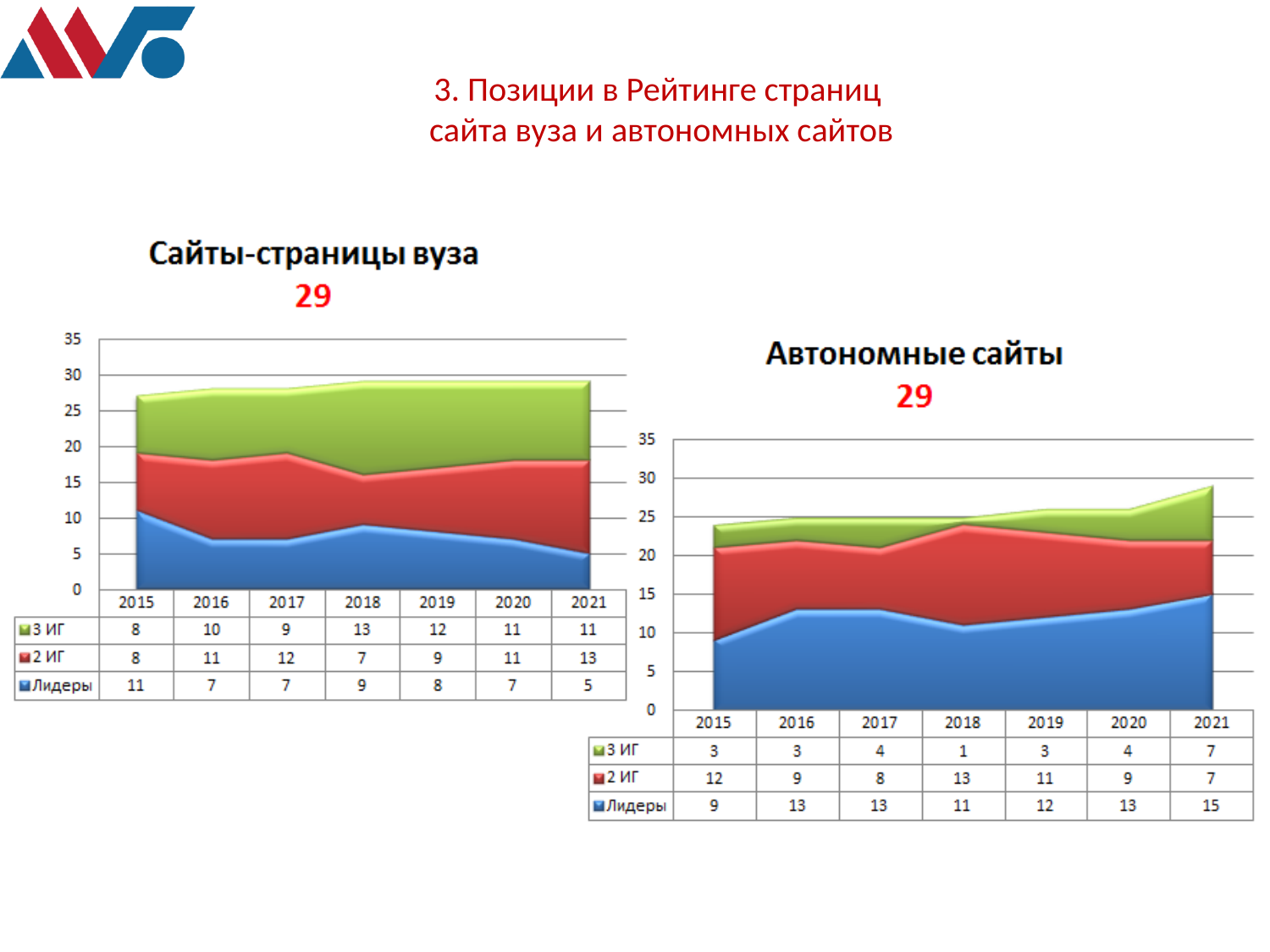
How many series does the legend of the chart titled "Автономные сайты" list? 3 In the chart titled "Автономные сайты", what is the value of "2 ИГ" for 2018? 13 How many years are shown on the x axis of the chart titled "Сайты-страницы вуза"? 7 In the chart titled "Сайты-страницы вуза", what is the difference between the "Лидеры" values for 2015 and 2021? 6 In the chart titled "Автономные сайты", which is larger for 2016: "2 ИГ" or "Лидеры"? Лидеры In the chart titled "Сайты-страницы вуза", what is the total of the stacked values for 2015? 27 In the chart titled "Автономные сайты", what is the total of the stacked values for 2021? 29 In the chart titled "Автономные сайты", what is the value of "Лидеры" for 2021? 15 In the chart titled "Сайты-страницы вуза", what is the value of "3 ИГ" for 2018? 13 In the chart titled "Сайты-страницы вуза", which year has the highest value for "2 ИГ"? 2021 In the chart titled "Автономные сайты", which year has the lowest value for "3 ИГ"? 2018 In the chart titled "Сайты-страницы вуза", what is the value of "Лидеры" for 2015? 11